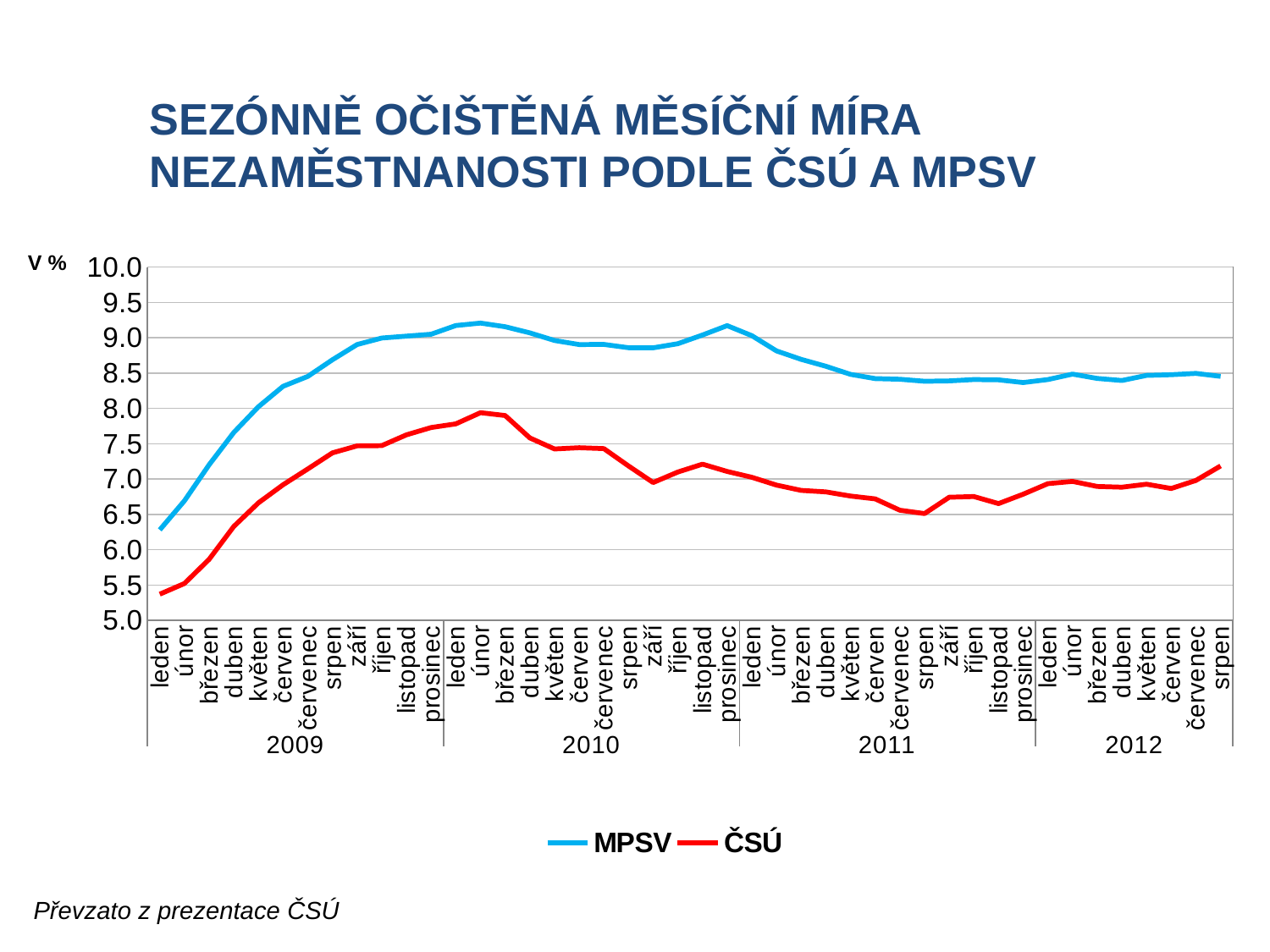
In which month and year is the ČSÚ series at its lowest? leden 2009 Which two series are shown in the legend? MPSV and ČSÚ Which series has the higher value in srpen 2012, MPSV or ČSÚ? MPSV What kind of chart is shown on the slide? line chart Is the ČSÚ value for leden 2009 greater or less than 6.0? less Is the MPSV value for únor 2010 greater or less than 9.0? greater How many series does the legend list? 2 Is the ČSÚ value for srpen 2011 greater or less than 7.0? less How many years are labelled on the x axis? 4 What colour is the ČSÚ line? red Does the MPSV series rise or fall from leden 2009 to prosinec 2009? rise